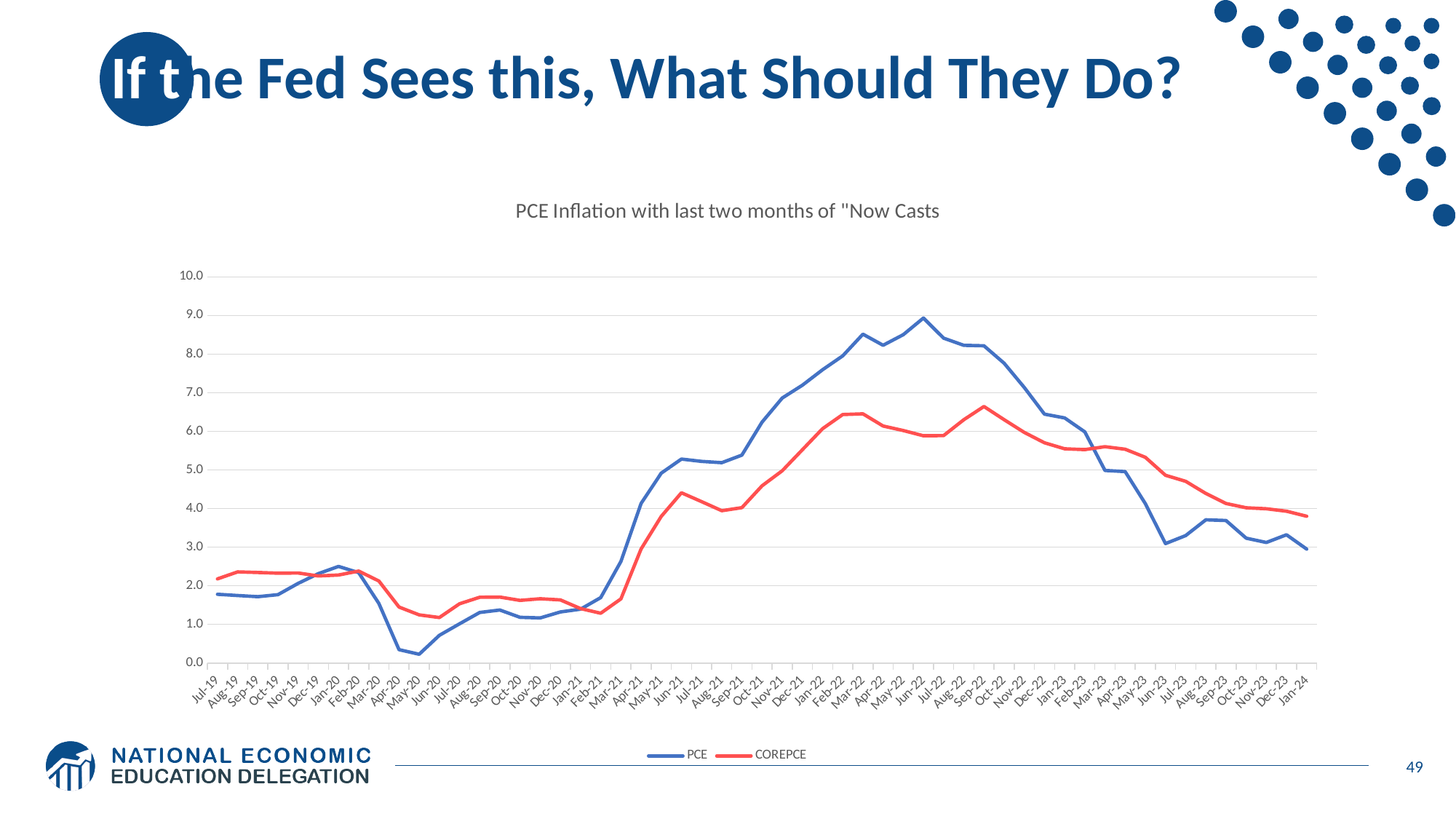
In Jan-24, which series has the higher value, PCE or COREPCE? COREPCE What are the two series named in the legend? PCE and COREPCE Is the COREPCE value for Sep-22 greater or less than 6.0? greater From Jun-22 to Jan-24, does the PCE series generally rise or fall? fall What is the title of the chart? PCE Inflation with last two months of "Now Casts In which month does the PCE series reach its lowest value? May-20 In which month does the PCE series reach its highest value? Jun-22 How many series does the legend list? 2 Is the PCE value for Jun-22 greater or less than 8.0? greater In which month does the COREPCE series reach its highest value? Sep-22 Is the PCE value for May-20 greater or less than 1.0? less What kind of chart is shown on the slide? line chart